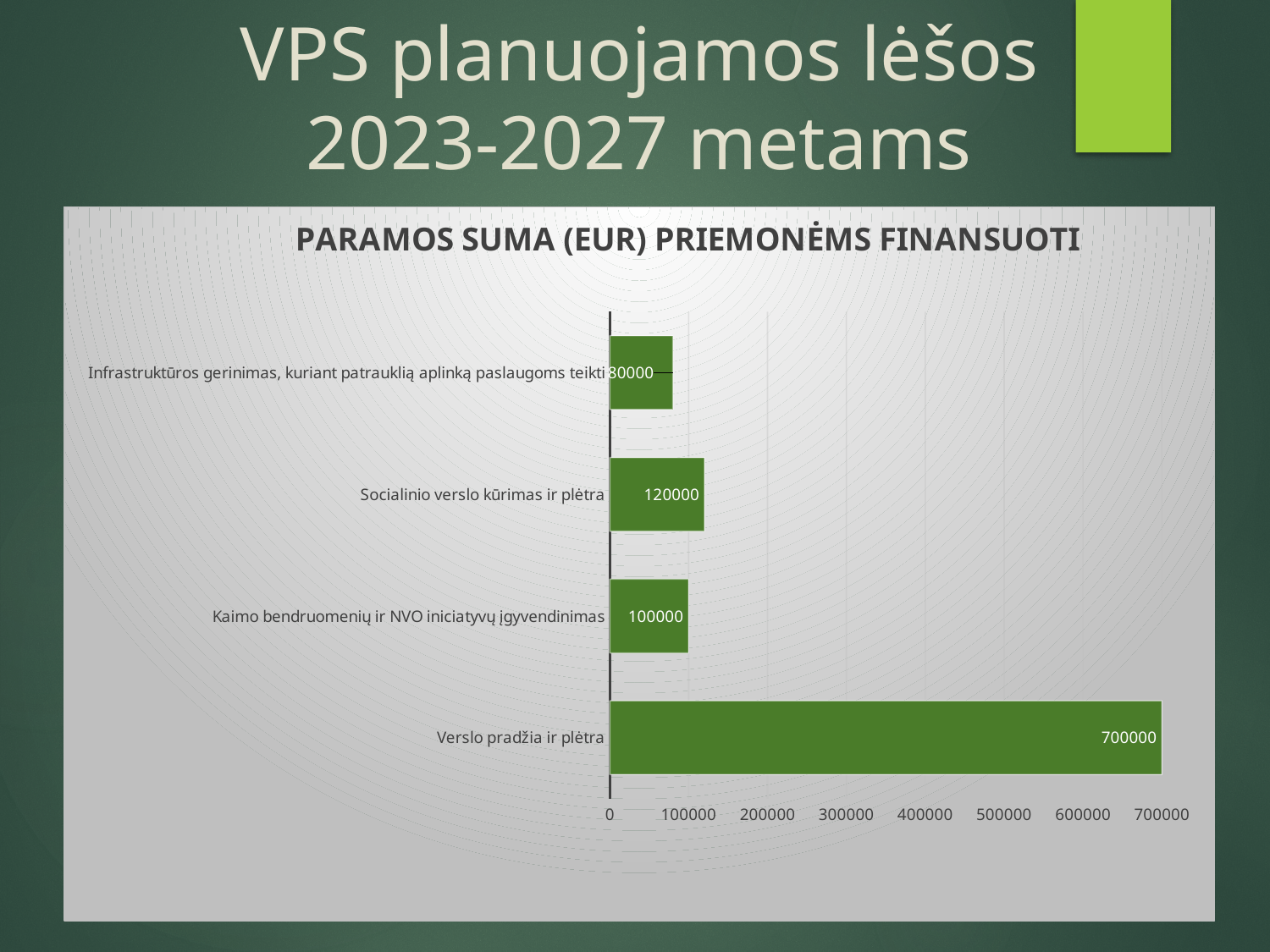
Which category has the lowest value? Infrastruktūros gerinimas, kuriant patrauklią aplinką paslaugoms teikti What is the value for Kaimo bendruomenių ir NVO iniciatyvų įgyvendinimas? 100000 What is the difference between the values for Socialinio verslo kūrimas ir plėtra and Kaimo bendruomenių ir NVO iniciatyvų įgyvendinimas? 20000 Which category has the highest value? Verslo pradžia ir plėtra What is the title of the chart? PARAMOS SUMA (EUR) PRIEMONĖMS FINANSUOTI What is the value for Socialinio verslo kūrimas ir plėtra? 120000 How many categories are shown in the chart? 4 What is the difference between the values for Verslo pradžia ir plėtra and Socialinio verslo kūrimas ir plėtra? 580000 Which is larger, the value for Kaimo bendruomenių ir NVO iniciatyvų įgyvendinimas or the value for Infrastruktūros gerinimas, kuriant patrauklią aplinką paslaugoms teikti? Kaimo bendruomenių ir NVO iniciatyvų įgyvendinimas What is the value for Verslo pradžia ir plėtra? 700000 What kind of chart is shown on the slide? Bar chart What is the value for Infrastruktūros gerinimas, kuriant patrauklią aplinką paslaugoms teikti? 80000